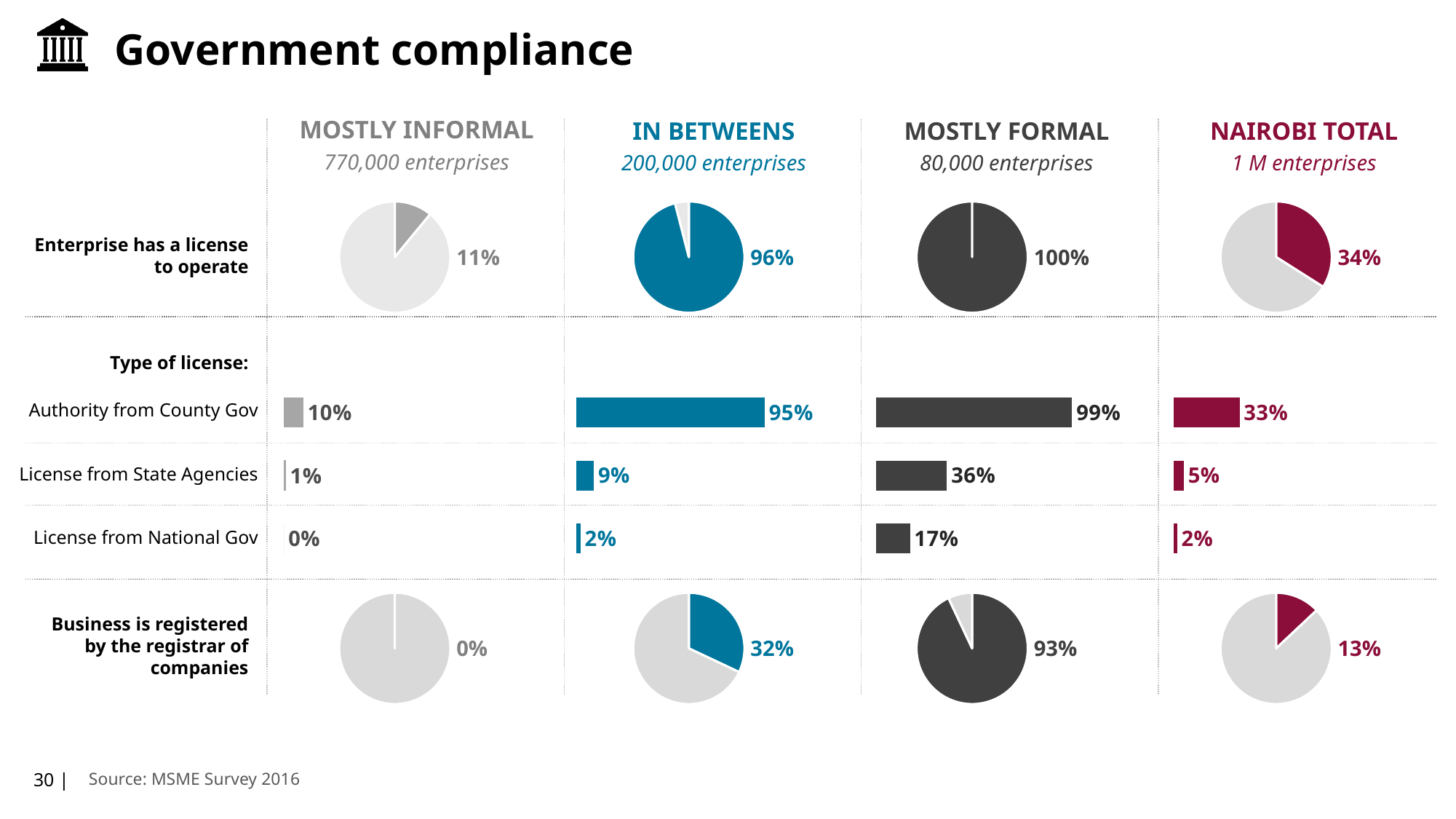
In the 'Enterprise has a license to operate' row, which segment has the highest percentage? Mostly Formal In the 'Type of license' bars, what percentage of Mostly Formal enterprises have a License from State Agencies? 36% In the 'Type of license' bars, which is larger for the In Betweens segment: License from State Agencies or License from National Gov? License from State Agencies What kind of chart is used for the 'Enterprise has a license to operate' row? Pie chart In the 'Enterprise has a license to operate' row, what percentage is shown for the Mostly Informal segment? 11% In the 'Business is registered by the registrar of companies' row, which segment has the lowest percentage? Mostly Informal How many enterprise segments (columns) are shown on the slide? 4 What kind of chart is used for the 'Type of license' rows? Bar chart In the 'Type of license' bars, what is the difference between the Mostly Formal and In Betweens percentages for Authority from County Gov? 4% In the 'Enterprise has a license to operate' row, what is the difference between the In Betweens and Mostly Informal percentages? 85% In the 'Business is registered by the registrar of companies' row, what percentage is shown for the In Betweens segment? 32% In the 'Enterprise has a license to operate' row, what percentage is shown for the Nairobi Total? 34%